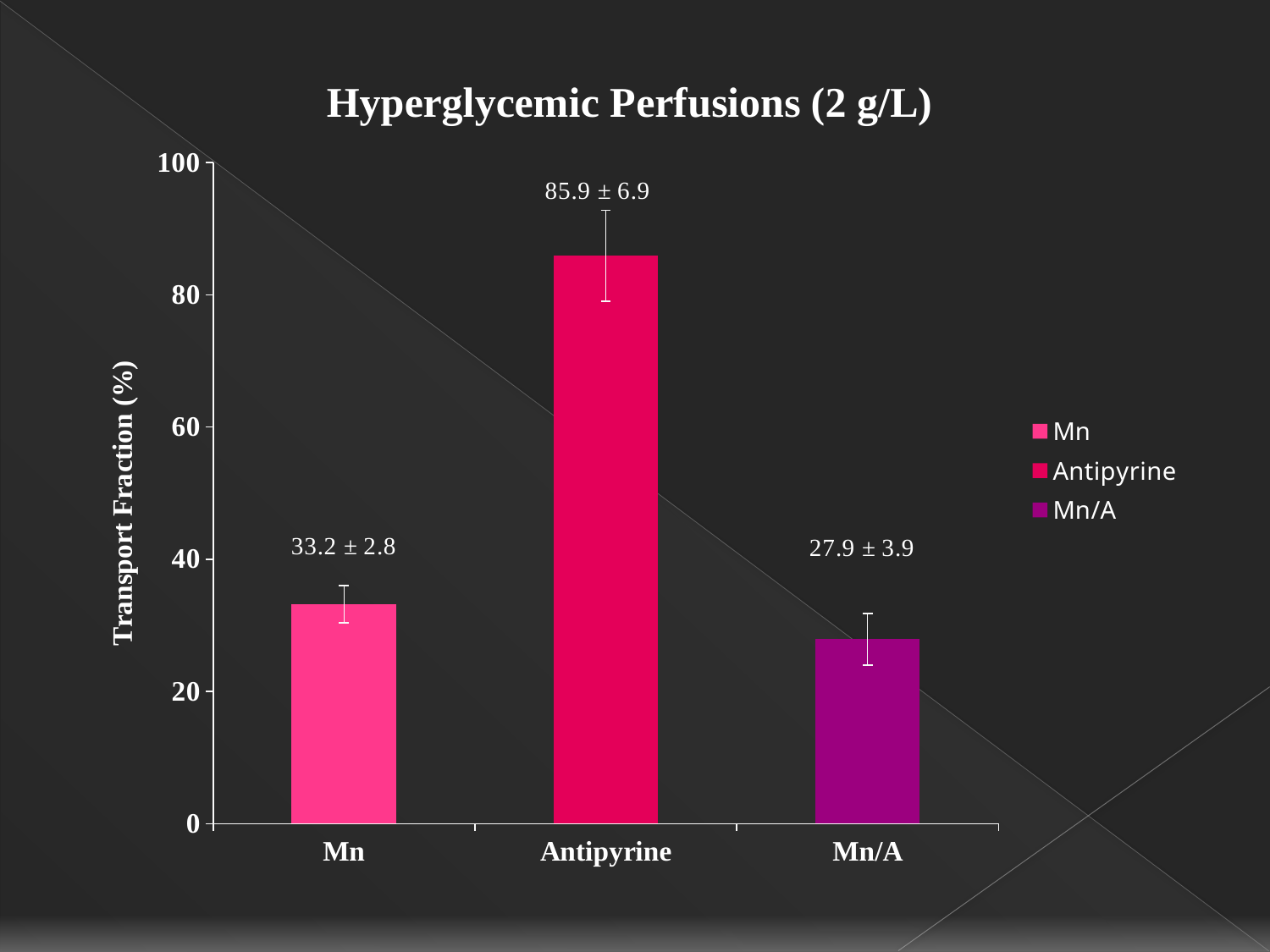
Which has a larger transport fraction, Mn or Mn/A? Mn Which category has the highest transport fraction? Antipyrine What kind of chart is shown on the slide? Bar chart Which category has the lowest transport fraction? Mn/A What is the difference between the mean transport fraction of Antipyrine and Mn? 52.7 What is the transport fraction value labelled for Mn/A? 27.9 ± 3.9 How many categories are shown on the x axis? 3 Is the value for Antipyrine greater or less than 80? greater How many entries does the legend list? 3 What is the title of the chart? Hyperglycemic Perfusions (2 g/L) What is the transport fraction value labelled for Mn? 33.2 ± 2.8 What is the transport fraction value labelled for Antipyrine? 85.9 ± 6.9